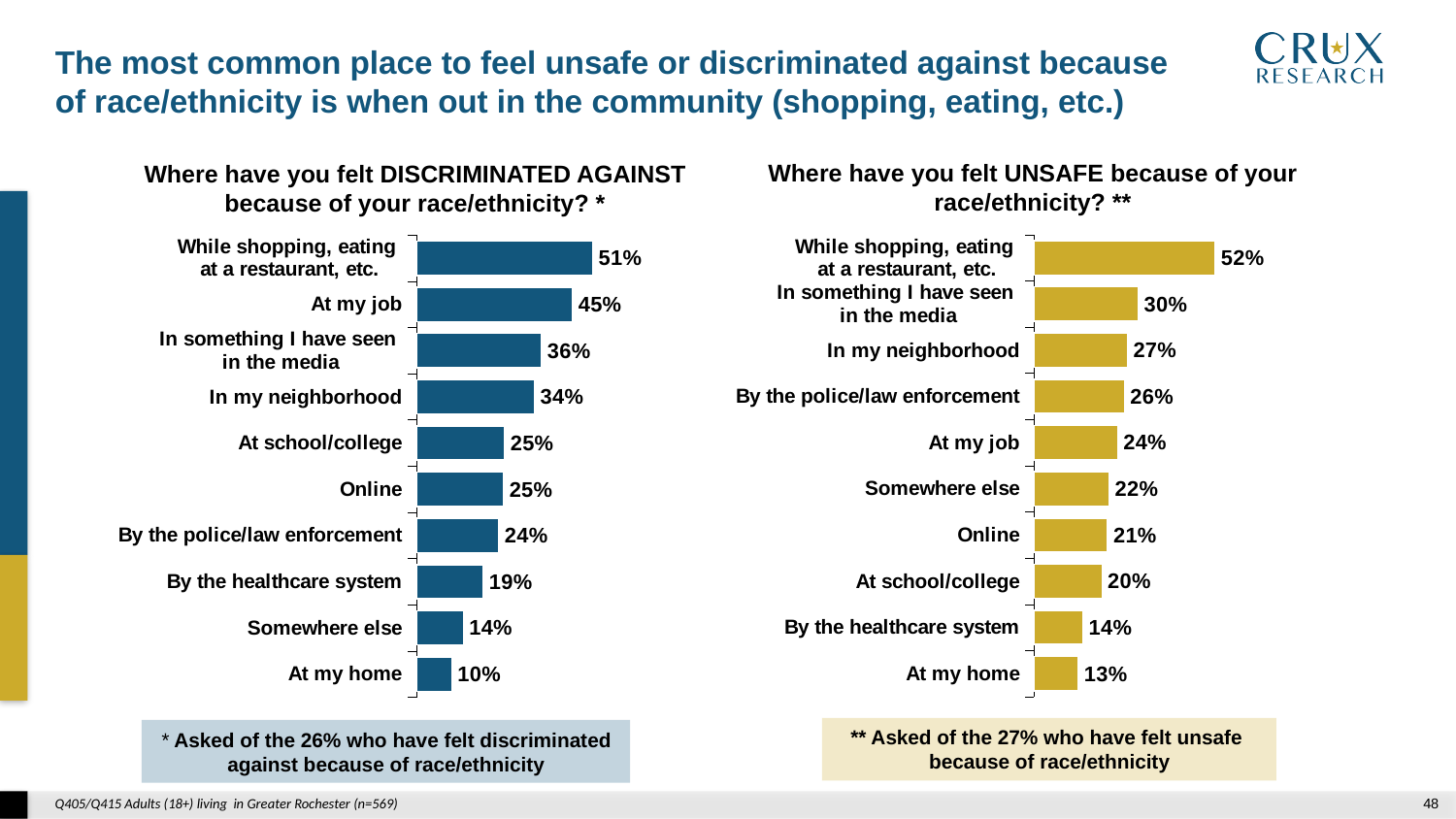
What colour are the bars in the 'Where have you felt UNSAFE because of your race/ethnicity?' chart? Gold/yellow In the 'Where have you felt DISCRIMINATED AGAINST because of your race/ethnicity?' chart, what is the difference between 'While shopping, eating at a restaurant, etc.' and 'At my home'? 41% In the 'Where have you felt UNSAFE because of your race/ethnicity?' chart, which category has the lowest value? At my home In the 'Where have you felt UNSAFE because of your race/ethnicity?' chart, what is the value for 'By the police/law enforcement'? 26% How many categories are shown in the 'Where have you felt UNSAFE because of your race/ethnicity?' chart? 10 In the 'Where have you felt UNSAFE because of your race/ethnicity?' chart, what is the difference between 'In something I have seen in the media' and 'In my neighborhood'? 3% In the 'Where have you felt UNSAFE because of your race/ethnicity?' chart, which is larger: 'Somewhere else' or 'At school/college'? Somewhere else In the 'Where have you felt DISCRIMINATED AGAINST because of your race/ethnicity?' chart, what is the value for 'By the healthcare system'? 19% In the 'Where have you felt DISCRIMINATED AGAINST because of your race/ethnicity?' chart, what is the value for 'At my job'? 45% In the 'Where have you felt DISCRIMINATED AGAINST because of your race/ethnicity?' chart, which category has the highest value? While shopping, eating at a restaurant, etc. What kind of chart is the 'Where have you felt DISCRIMINATED AGAINST because of your race/ethnicity?' chart? Bar chart In the 'Where have you felt DISCRIMINATED AGAINST because of your race/ethnicity?' chart, which is larger: 'In something I have seen in the media' or 'By the police/law enforcement'? In something I have seen in the media